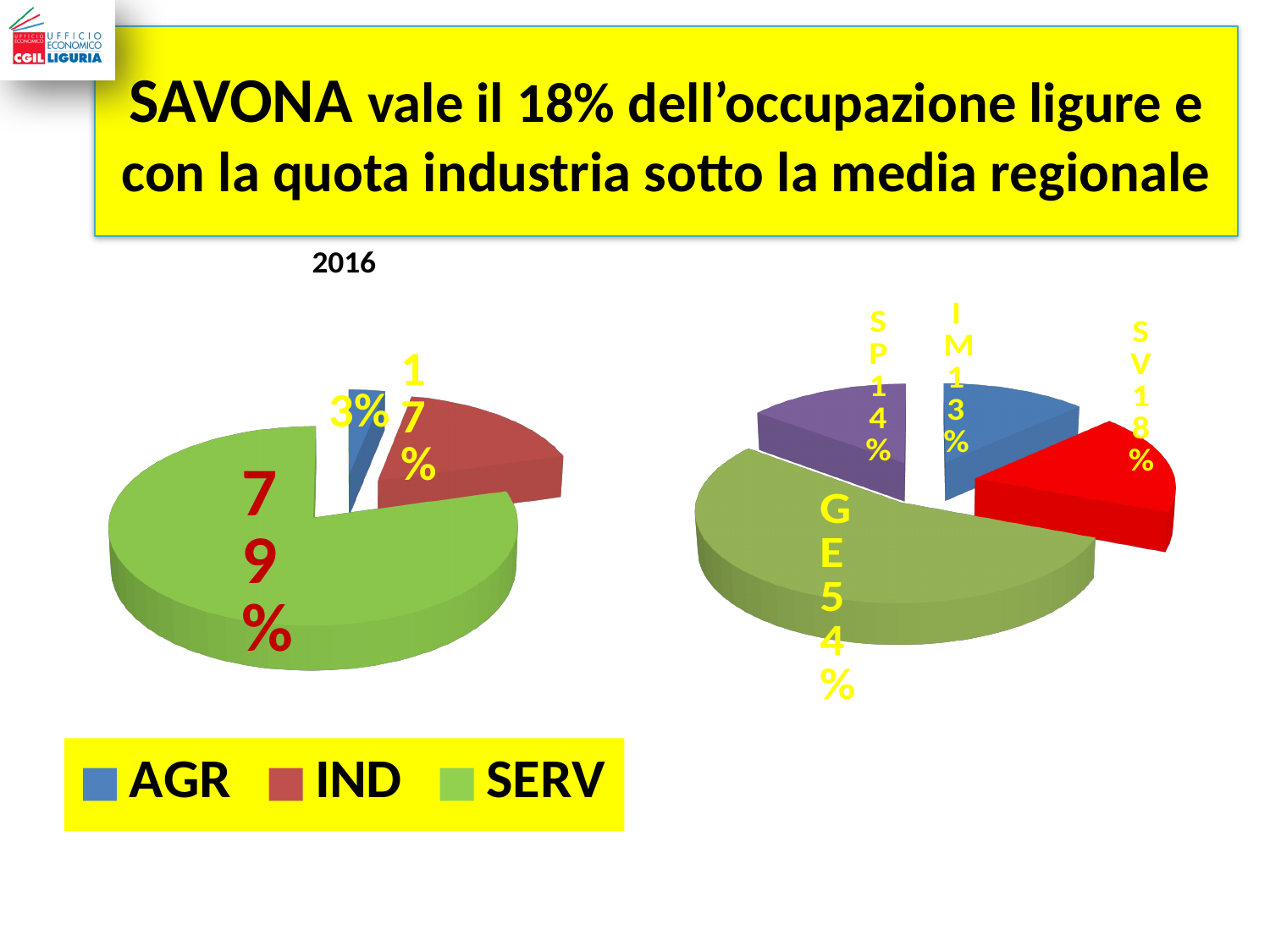
On the left pie chart titled 2016, what share is shown for AGR? 3% On the left pie chart titled 2016, which category has the largest slice? SERV On the right pie chart, which slice is larger, SP or IM? SP On the right pie chart, how many slices are there? 4 On the left pie chart titled 2016, which category has the smallest slice? AGR On the left pie chart titled 2016, what is the difference in percentage points between SERV and IND? 62 On the left pie chart titled 2016, what share is shown for SERV? 79% What kind of chart is the chart on the right of the slide? Pie chart On the left pie chart titled 2016, what share is shown for IND? 17% On the right pie chart, what share is shown for GE? 54% On the right pie chart, what share is shown for SV? 18% On the left pie chart titled 2016, how many entries does the legend list? 3